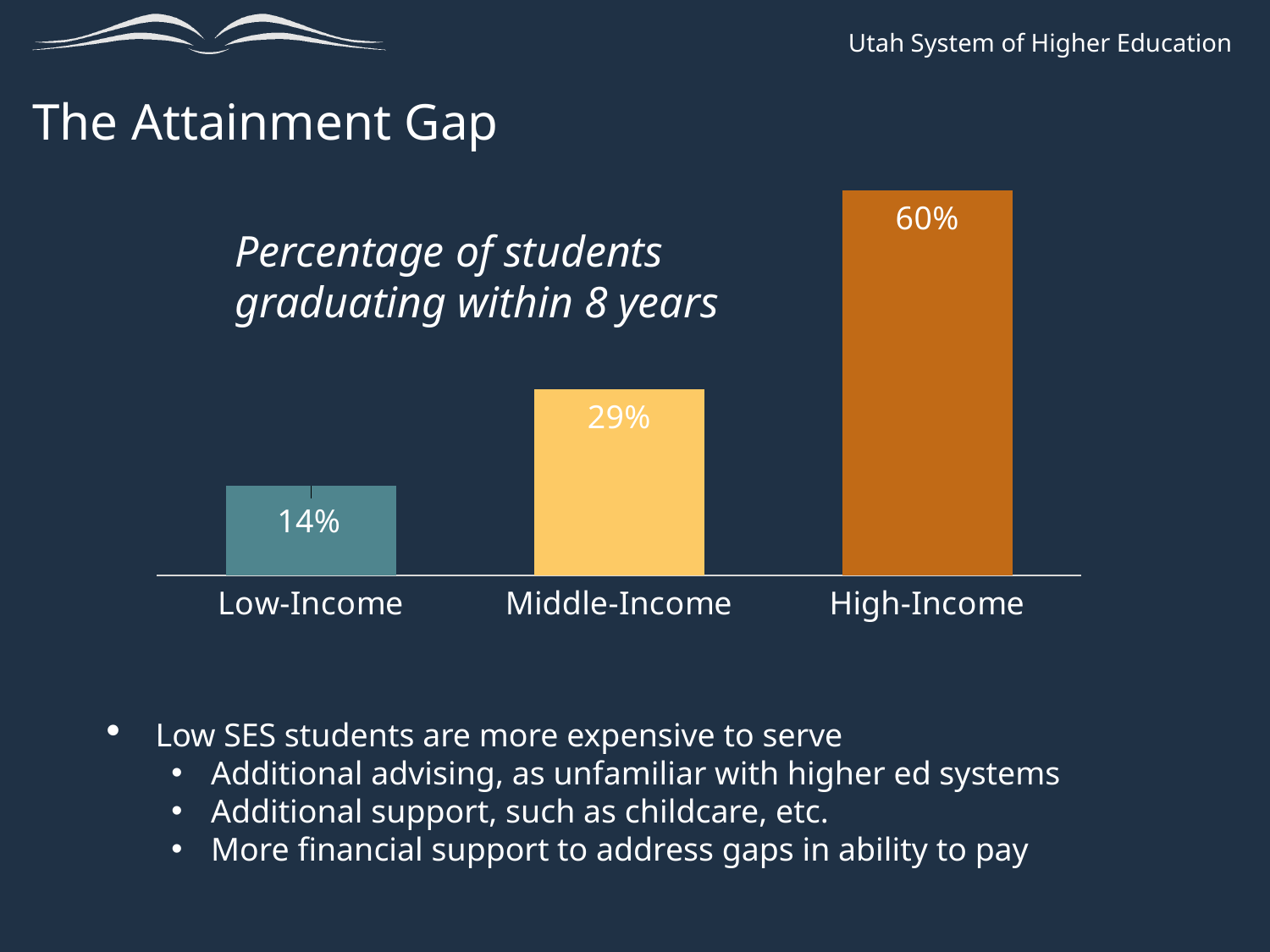
Which income group has the lowest percentage of students graduating within 8 years? Low-Income What percentage of low-income students graduate within 8 years? 14% Which income group has the highest percentage of students graduating within 8 years? High-Income Do the values rise or fall moving from Low-Income to High-Income along the x axis? Rise What type of chart is used to show the percentage of students graduating within 8 years? Bar chart What is the difference in percentage points between the high-income and low-income graduation rates? 46 What is the difference in percentage points between the middle-income and low-income graduation rates? 15 How many income groups are shown in the chart? 3 Which group has a higher graduation rate, middle-income or low-income? Middle-Income What percentage of middle-income students graduate within 8 years? 29% What is the title of the chart? Percentage of students graduating within 8 years What percentage of high-income students graduate within 8 years? 60%